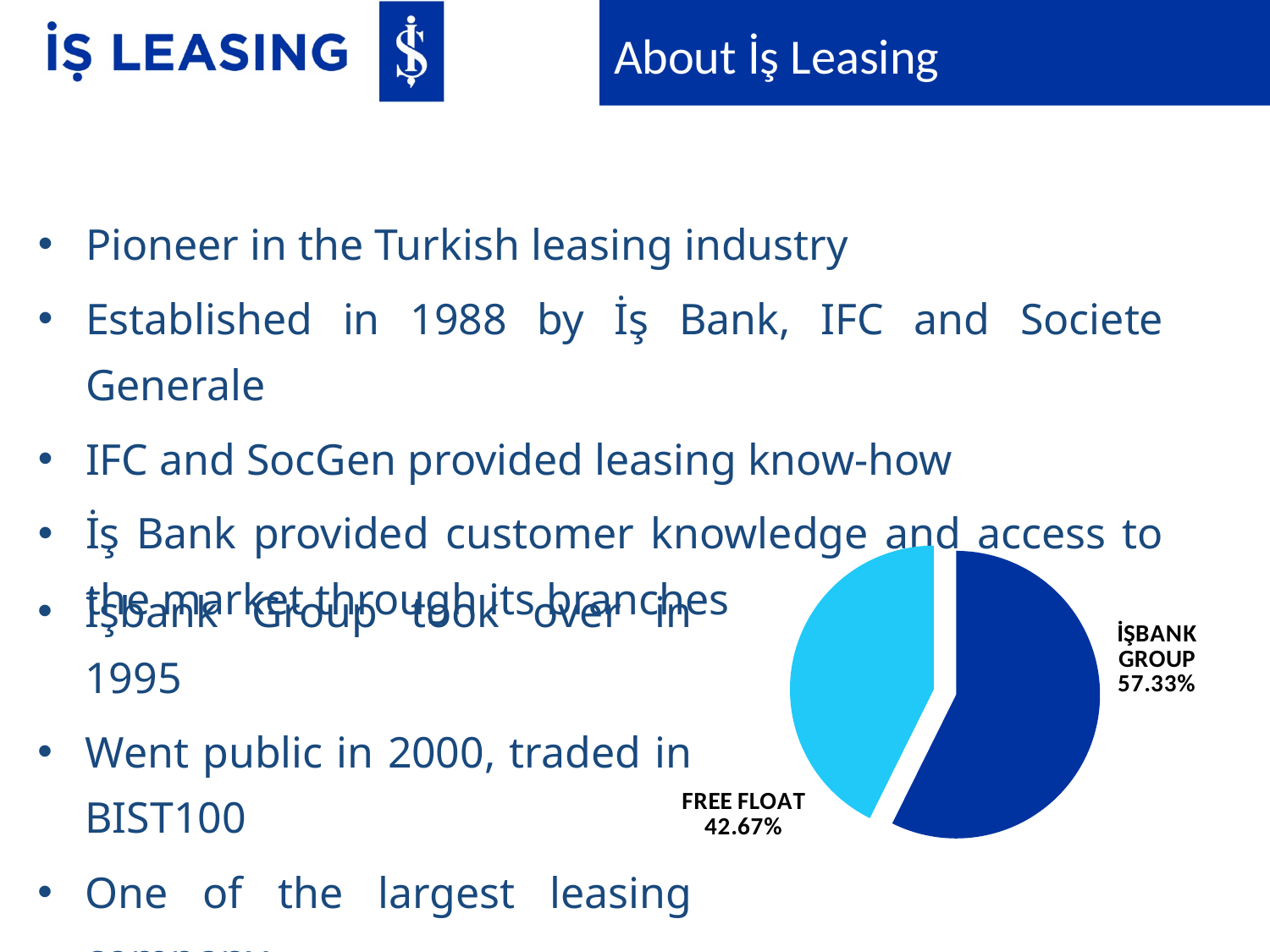
Is the FREE FLOAT share greater or less than 50%? less What share of the pie does FREE FLOAT hold? 42.67% Is the İŞBANK GROUP share greater or less than 50%? greater What kind of chart is shown on the slide? pie chart Which slice of the pie is the smallest? FREE FLOAT How many slices does the pie chart have? 2 Which is larger, the İŞBANK GROUP slice or the FREE FLOAT slice? İŞBANK GROUP What colour is the İŞBANK GROUP slice of the pie? dark blue What share of the pie does İŞBANK GROUP hold? 57.33% What is the difference in percentage points between the İŞBANK GROUP and FREE FLOAT slices? 14.66 What colour is the FREE FLOAT slice of the pie? light blue Which slice of the pie is the largest? İŞBANK GROUP